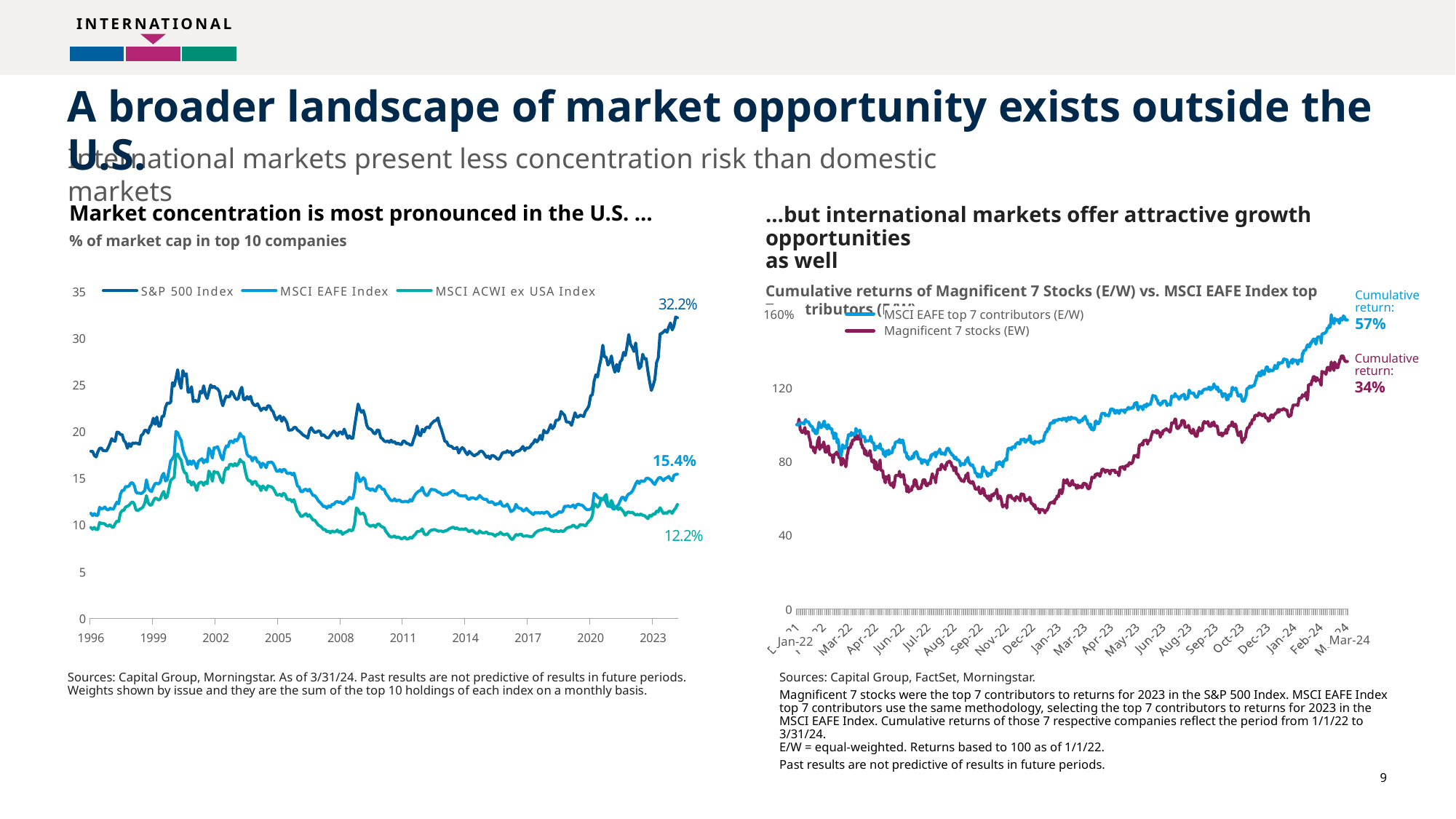
On the left chart, which index has the lowest latest value? MSCI ACWI ex USA Index On the right chart, which series has the larger cumulative return, MSCI EAFE top 7 contributors (E/W) or Magnificent 7 stocks (EW)? MSCI EAFE top 7 contributors (E/W) On the right chart, what is the cumulative return shown for the Magnificent 7 stocks (EW)? 34% On the left chart, what is the difference between the latest S&P 500 Index value and the latest MSCI EAFE Index value? 16.8% On the left chart, which index has the highest latest value? S&P 500 Index How many series does the legend of the left chart list? 3 On the left chart, what is the latest value shown for the S&P 500 Index? 32.2% On the left chart, what is the latest value shown for the MSCI EAFE Index? 15.4% On the right chart, what is the cumulative return shown for the MSCI EAFE top 7 contributors (E/W)? 57% On the right chart, what is the difference between the cumulative returns of the MSCI EAFE top 7 contributors (E/W) and the Magnificent 7 stocks (EW)? 23% What kind of chart is the left chart? Line chart On the left chart, what is the latest value shown for the MSCI ACWI ex USA Index? 12.2%